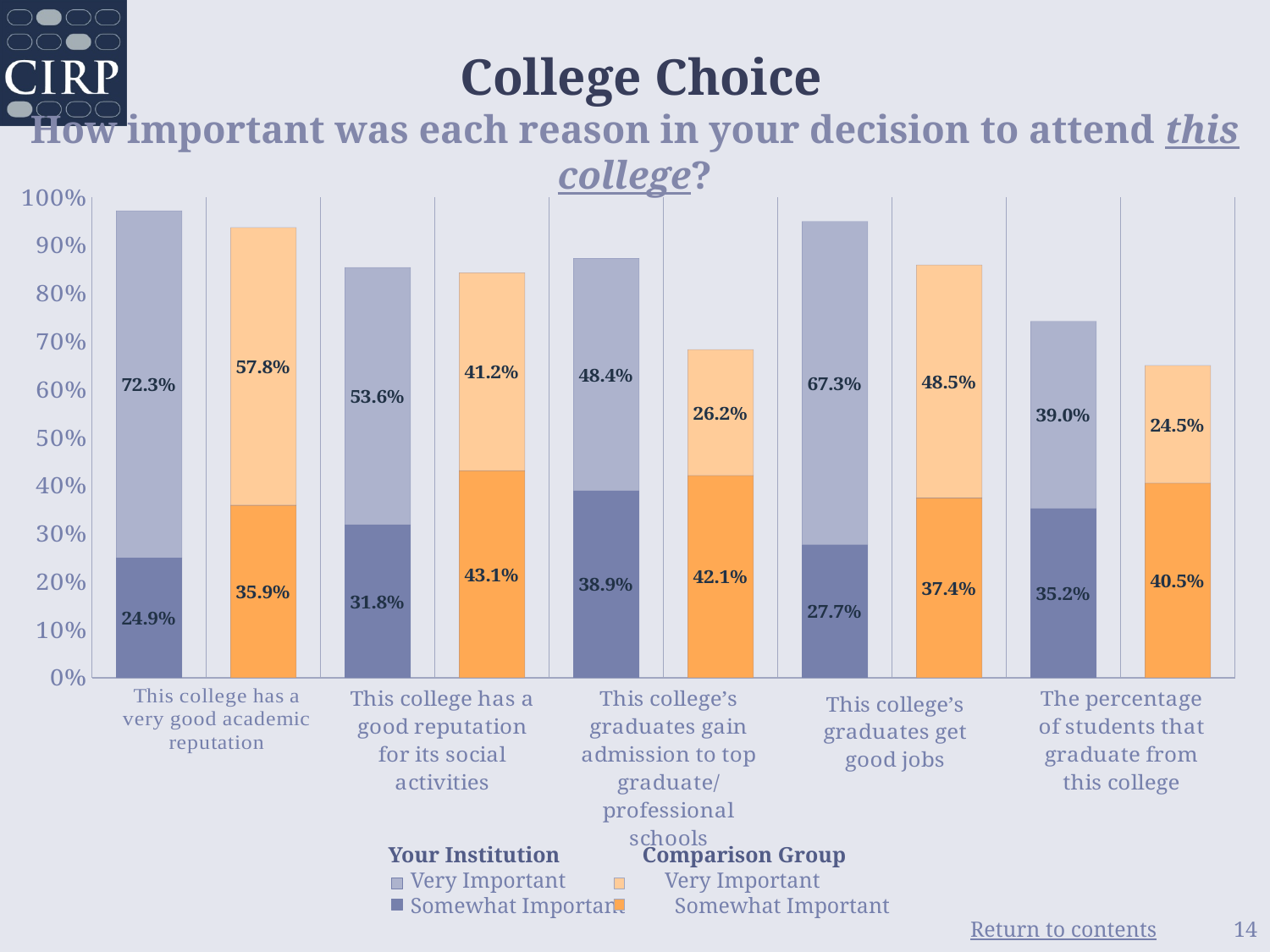
Which reason has the highest Very Important percentage for Your Institution? This college has a very good academic reputation For "This college has a good reputation for its social activities", which is larger: the Your Institution Somewhat Important value or the Comparison Group Somewhat Important value? Comparison Group (43.1%) What percentage of Your Institution respondents rated "This college has a very good academic reputation" as Very Important? 72.3% What kind of chart is shown on the slide? Stacked bar chart What is the total (Very Important plus Somewhat Important) for Your Institution on "This college's graduates get good jobs"? 95.0% Which reason has the lowest Very Important percentage for the Comparison Group? The percentage of students that graduate from this college What percentage of the Comparison Group rated "This college's graduates get good jobs" as Somewhat Important? 37.4% What is the Very Important percentage for the Comparison Group on "The percentage of students that graduate from this college"? 24.5% What is the difference between the Your Institution and Comparison Group Very Important percentages for "This college's graduates gain admission to top graduate/professional schools"? 22.2% How many reasons (categories) are shown on the x axis? 5 How many entries does the legend list? 4 What is the total (Very Important plus Somewhat Important) for the Comparison Group on "The percentage of students that graduate from this college"? 65.0%